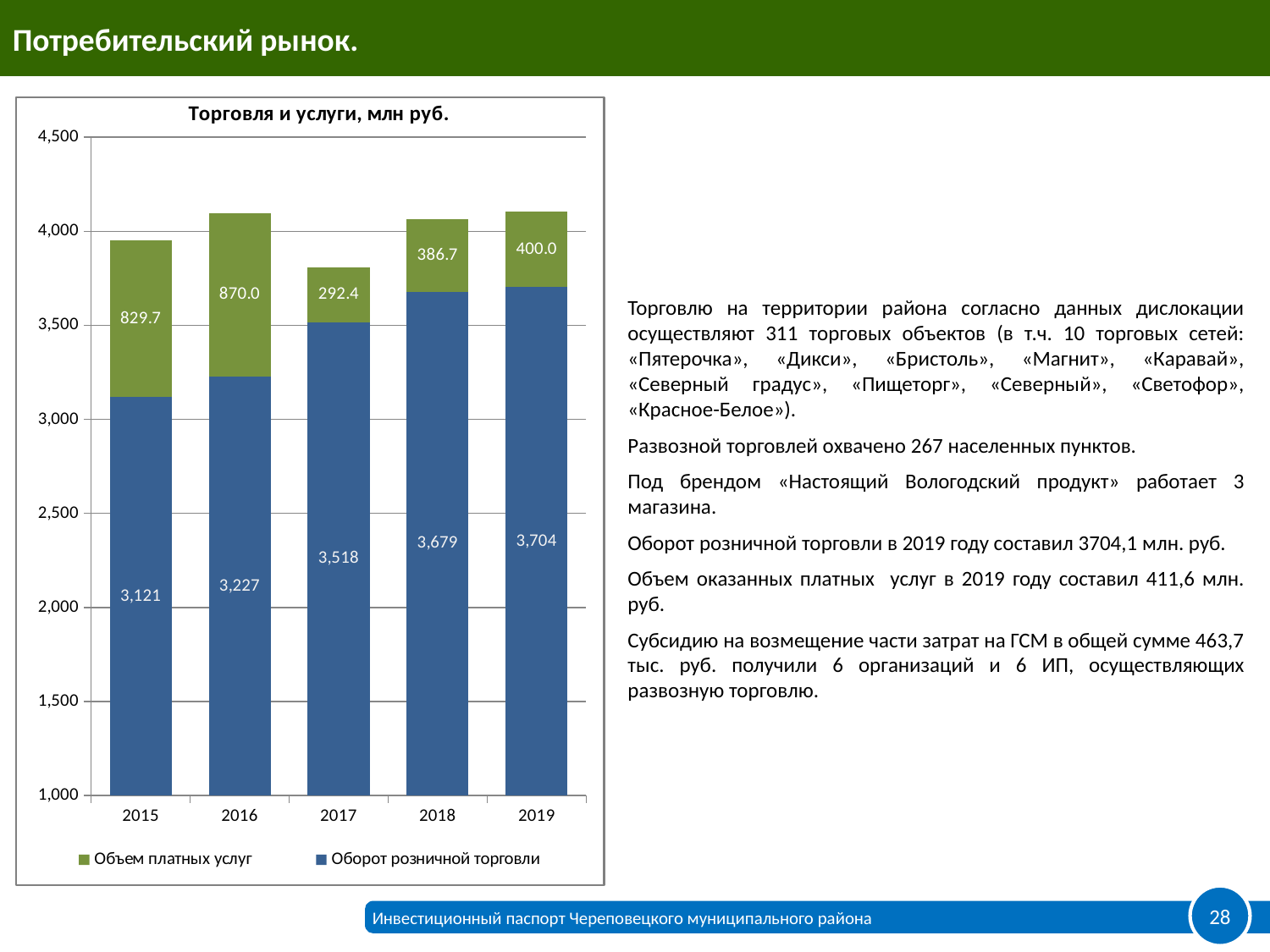
What is the value of Объем платных услуг for 2016? 870.0 What is the value of Объем платных услуг for 2017? 292.4 How many years are shown on the x axis? 5 Which is larger: Объем платных услуг in 2018 or in 2019? 2019 What kind of chart is shown on the slide? Stacked bar chart Which year has the highest value for Оборот розничной торговли? 2019 Does Оборот розничной торговли rise or fall from 2015 to 2019? Rises What is the value of Оборот розничной торговли for 2019? 3,704 What is the total of the stacked bar for 2019? 4,104.0 Which year has the lowest value for Объем платных услуг? 2017 What is the difference between Оборот розничной торговли in 2019 and in 2015? 583 How many series does the legend list? 2